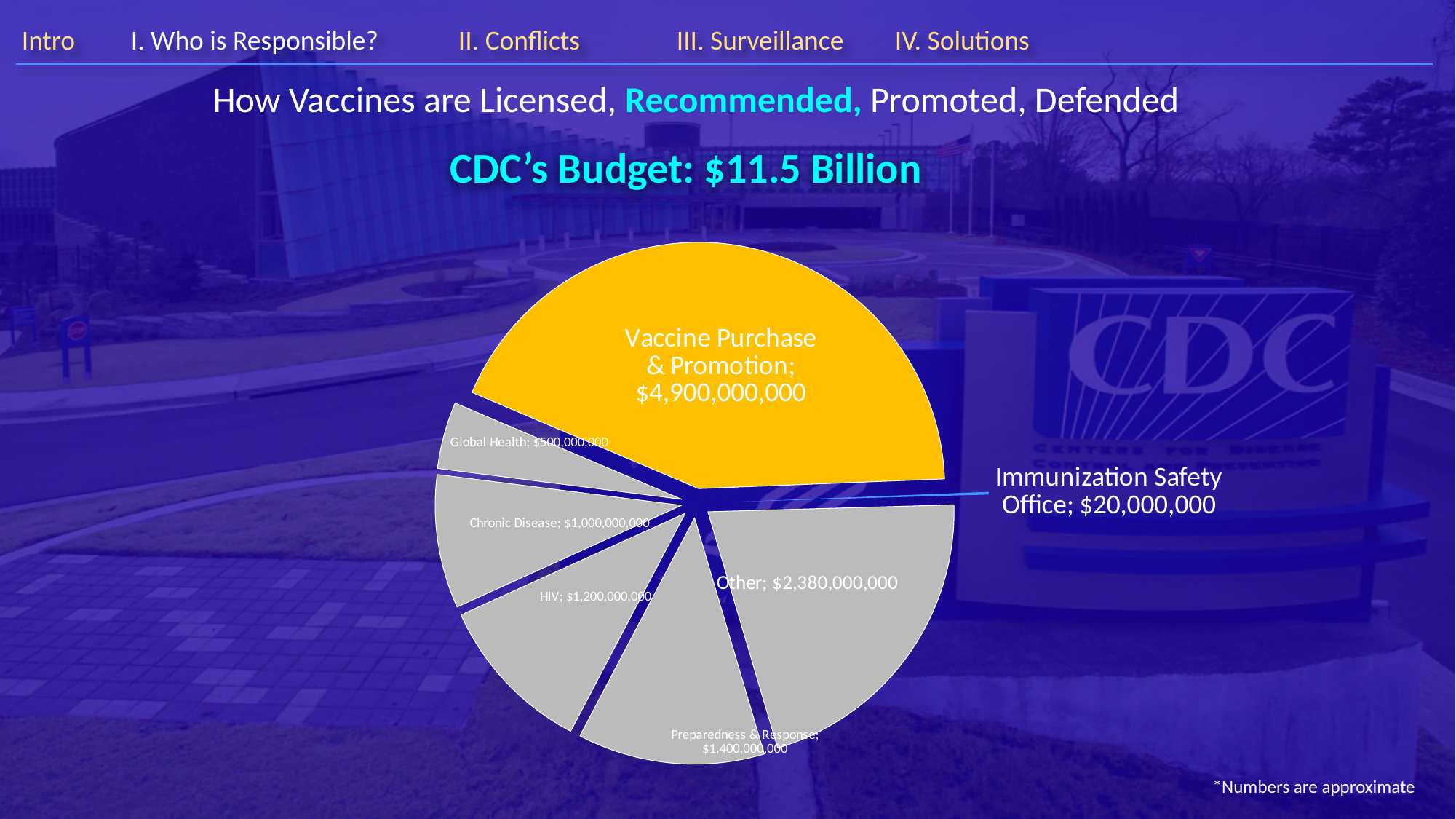
What is the value for Vaccine Purchase & Promotion? $4,900,000,000 What kind of chart is shown on the slide? pie chart Which slice of the pie is coloured yellow/orange rather than grey? Vaccine Purchase & Promotion Which category has the largest slice of the pie? Vaccine Purchase & Promotion Which category has the smallest slice of the pie? Immunization Safety Office What is the value for Global Health? $500,000,000 What is the value for the Immunization Safety Office slice? $20,000,000 Which is larger, Preparedness & Response or HIV? Preparedness & Response How many slices does the pie chart have? 7 What is the difference between HIV and Chronic Disease? $200,000,000 What is the value for Preparedness & Response? $1,400,000,000 What is the difference between Vaccine Purchase & Promotion and Other? $2,520,000,000